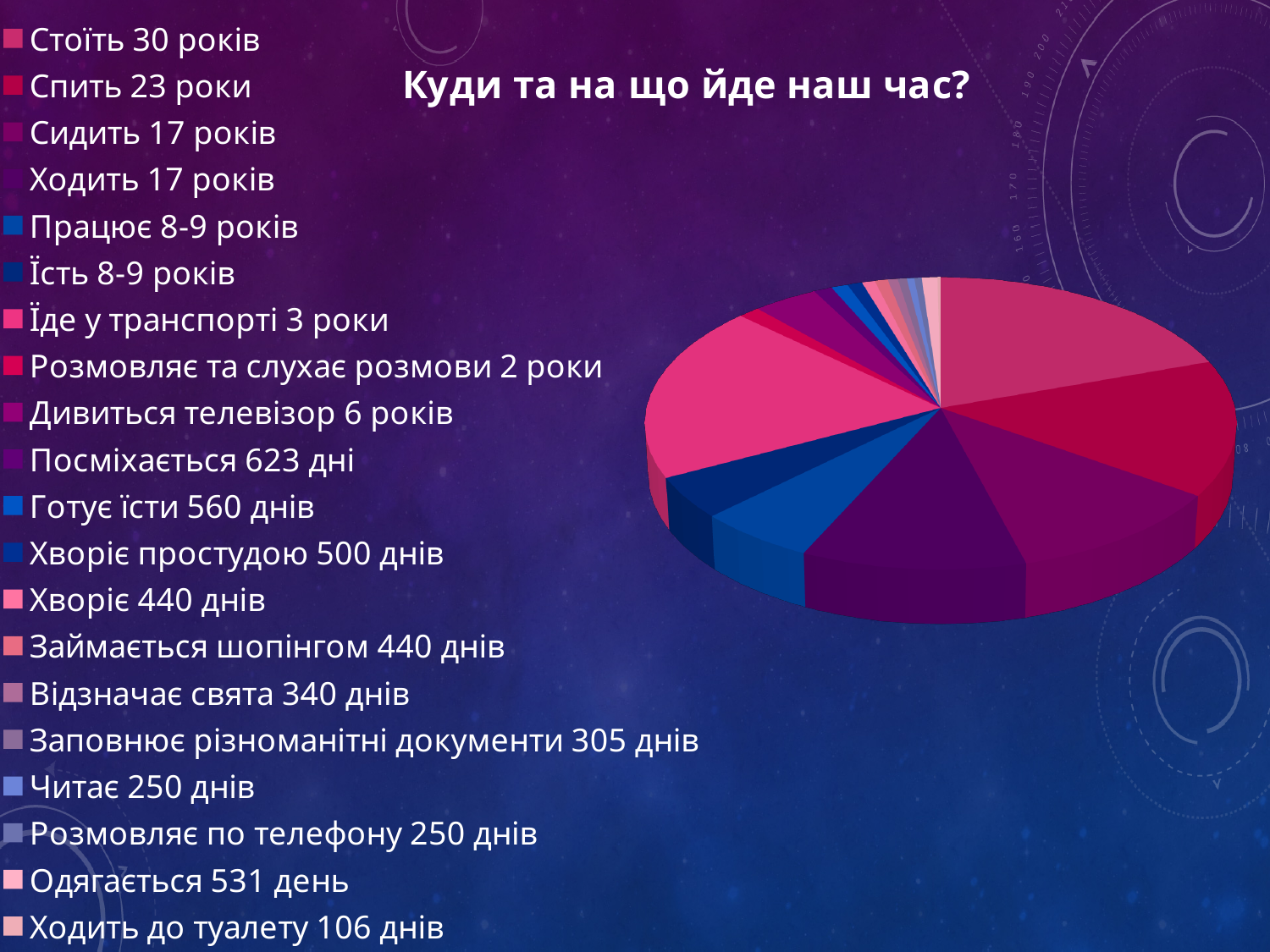
According to the legend, how many years does a person spend sleeping (Спить)? 23 роки According to the legend, how many days does a person spend smiling (Посміхається)? 623 дні Which category has the smallest value listed in the legend? Ходить до туалету 106 днів According to the legend, how many days does a person spend cooking (Готує їсти)? 560 днів According to the legend, how many days does a person spend going to the toilet (Ходить до туалету)? 106 днів How many categories does the legend of the pie chart list? 20 What is the difference in years between Стоїть (30 років) and Спить (23 роки)? 7 років What is the difference in days between Посміхається (623 дні) and Готує їсти (560 днів)? 63 дні Which is larger: the time for Стоїть or the time for Спить? Стоїть What kind of chart is shown on the slide? pie chart What is the title of the chart? Куди та на що йде наш час?